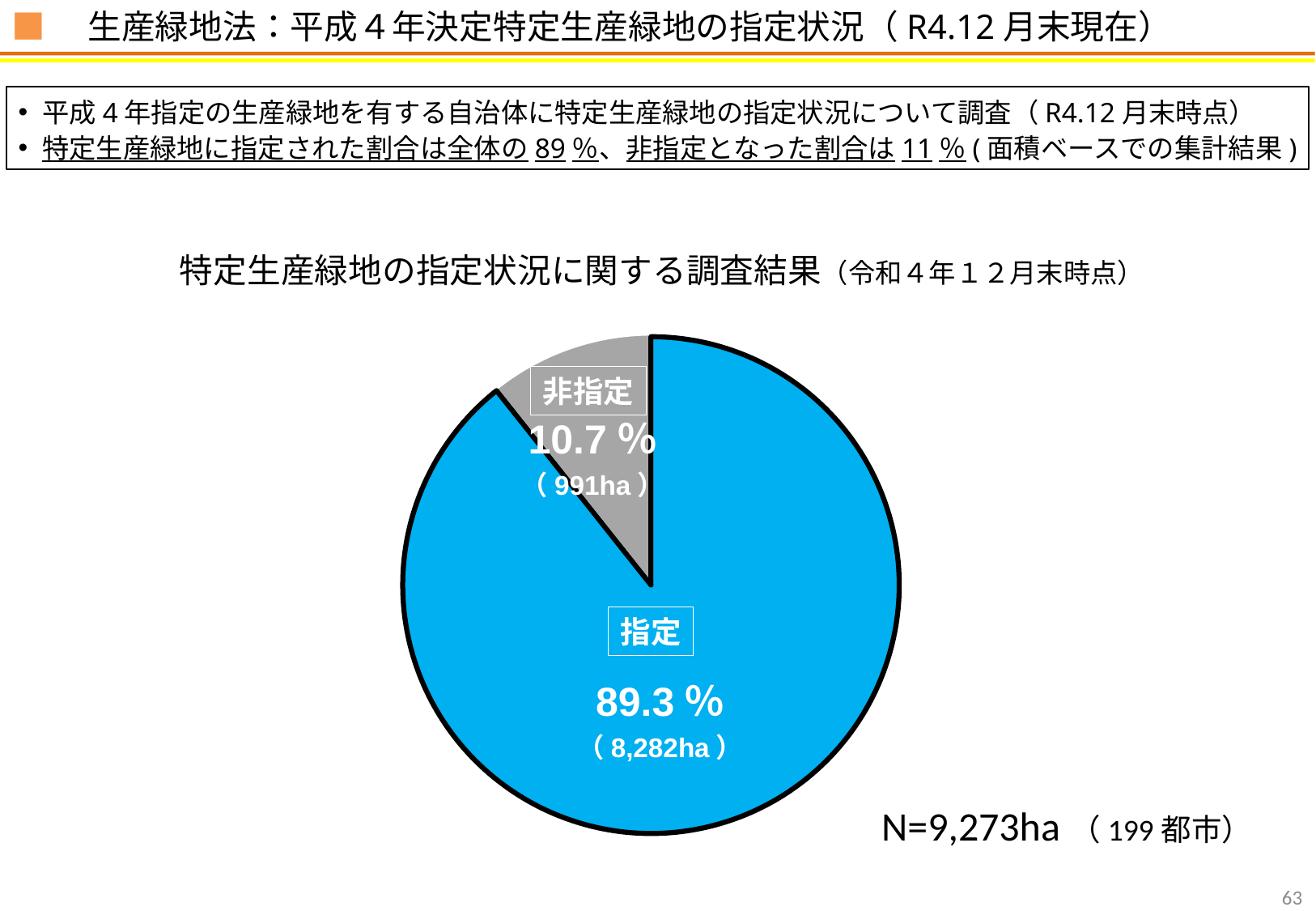
What is the difference in percentage points between the 指定 and 非指定 slices? 78.6 percentage points What area in hectares is shown for the 非指定 slice? 991ha What percentage share does the 指定 slice have? 89.3% What total area (N) is stated below the pie chart? N=9,273ha What area in hectares is shown for the 指定 slice? 8,282ha Which slice is the smallest in the pie chart? 非指定 What type of chart is shown on the slide? pie chart Which slice is the largest in the pie chart? 指定 What percentage share does the 非指定 slice have? 10.7% What colour is the 指定 slice of the pie chart? blue How many slices does the pie chart have? 2 Which is larger, the area for 指定 or the area for 非指定? 指定